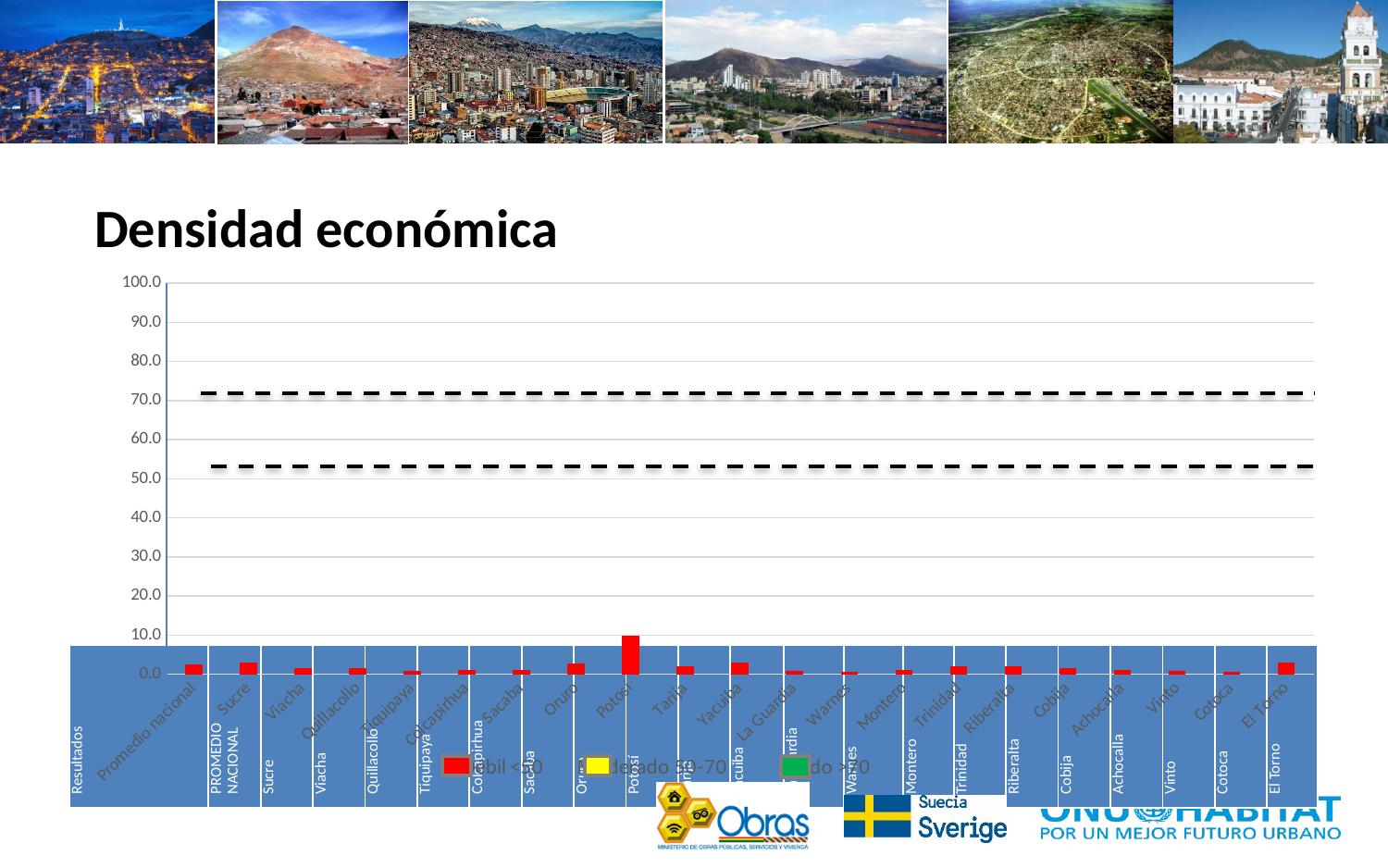
Is the value for Promedio nacional greater or less than 50.0? less What kind of chart is shown on the slide? bar chart Which has the larger value, Potosí or Warnes? Potosí Which has the larger value, Potosí or Sucre? Potosí What colour are the bars in the chart? red Is the value for Oruro greater or less than 20.0? less What is the title of the chart? Densidad económica What is the highest value shown on the y axis of the chart? 100.0 Which city has the highest bar in the chart? Potosí How many categories are plotted along the x axis of the chart? 21 Is the value for Sucre greater or less than 10.0? less